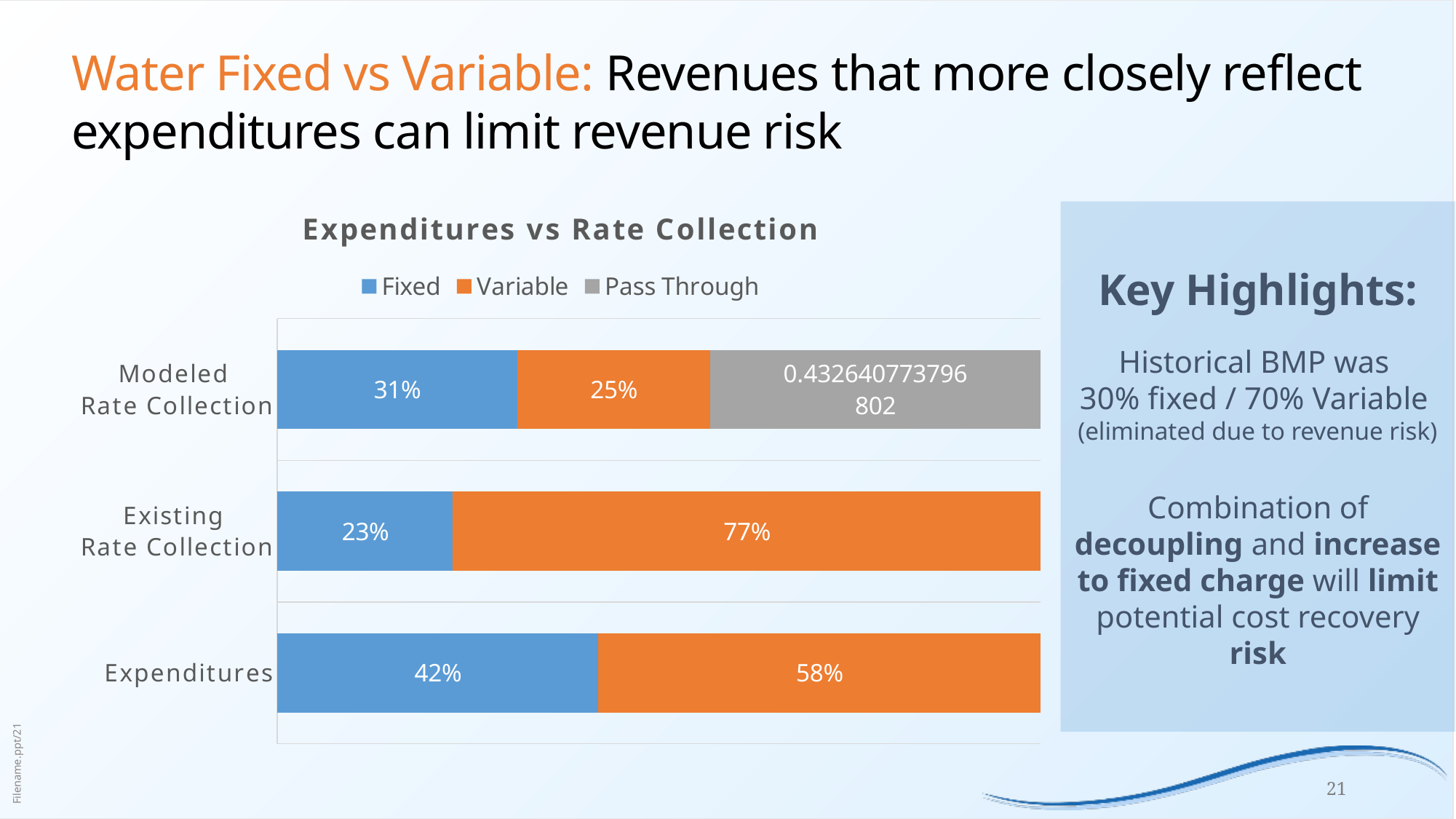
Which category has the highest Fixed value? Expenditures Which is larger: the Variable value for Existing Rate Collection or the Variable value for Expenditures? Existing Rate Collection What type of chart is shown on the slide? Stacked bar chart What is the Variable value for Existing Rate Collection? 77% What is the Fixed value for Modeled Rate Collection? 31% Which category has the lowest Fixed value? Existing Rate Collection What is the difference between the Variable and Fixed values for Existing Rate Collection? 54% How many series does the chart legend list? 3 What is the Variable value for Modeled Rate Collection? 25% What is the Fixed value for Expenditures? 42% How many categories are shown on the chart? 3 What is the title of the chart? Expenditures vs Rate Collection